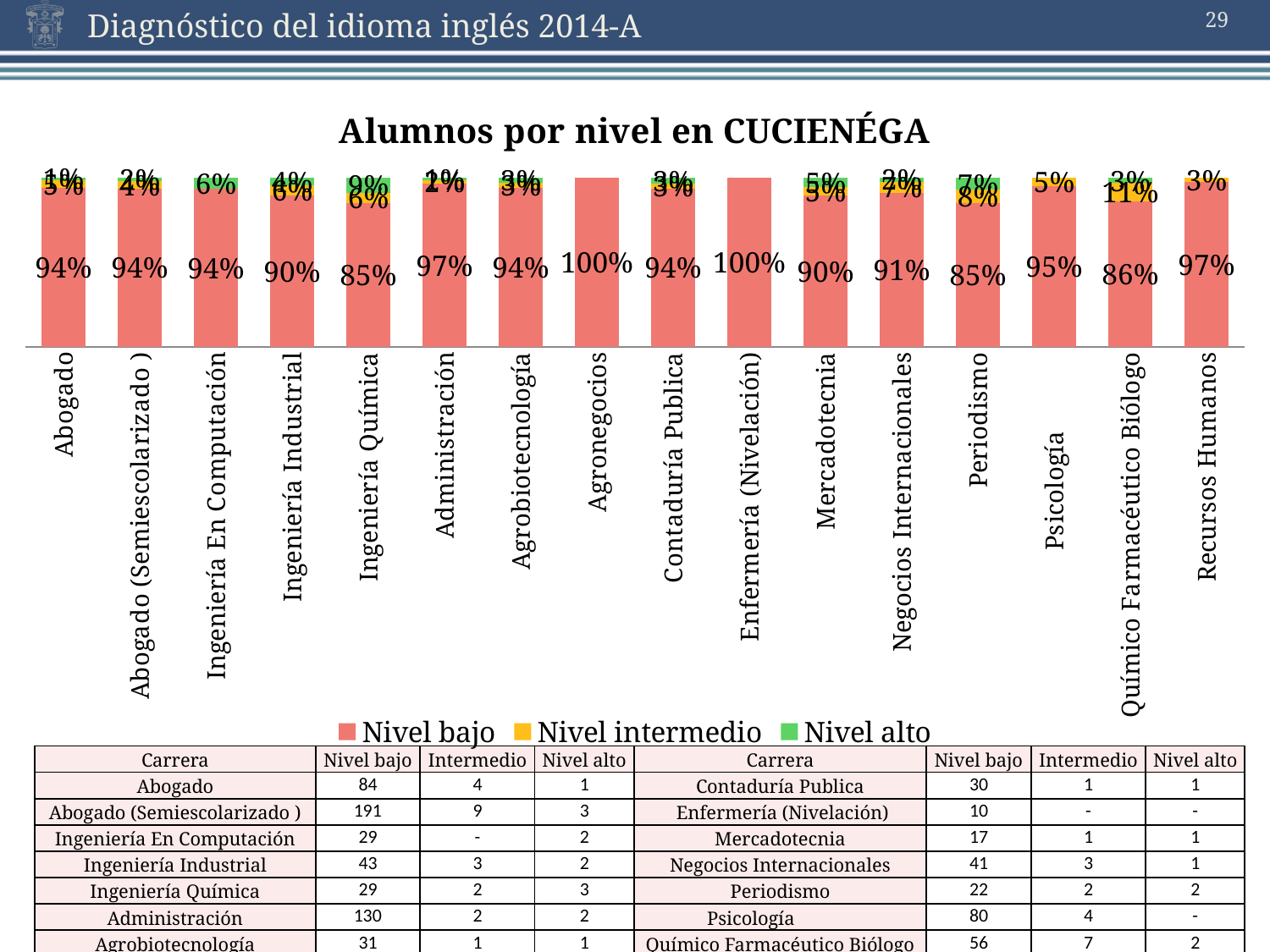
What kind of chart is shown on the slide? Stacked bar chart What is the Nivel bajo percentage for Ingeniería Química? 85% What is the title of the chart? Alumnos por nivel en CUCIENÉGA Which has a larger Nivel bajo percentage, Psicología or Químico Farmacéutico Biólogo? Psicología What is the Nivel alto percentage for Ingeniería En Computación? 6% How many careers (categories) are plotted on the x axis of the chart? 16 What is the Nivel bajo percentage for Agronegocios? 100% How many series does the chart legend list? 3 What is the Nivel bajo percentage for Negocios Internacionales? 91% What is the Nivel bajo percentage for Administración? 97% What is the difference in Nivel bajo percentage between Administración and Ingeniería Industrial? 7 percentage points Which careers show the highest Nivel bajo percentage in the chart? Agronegocios and Enfermería (Nivelación)